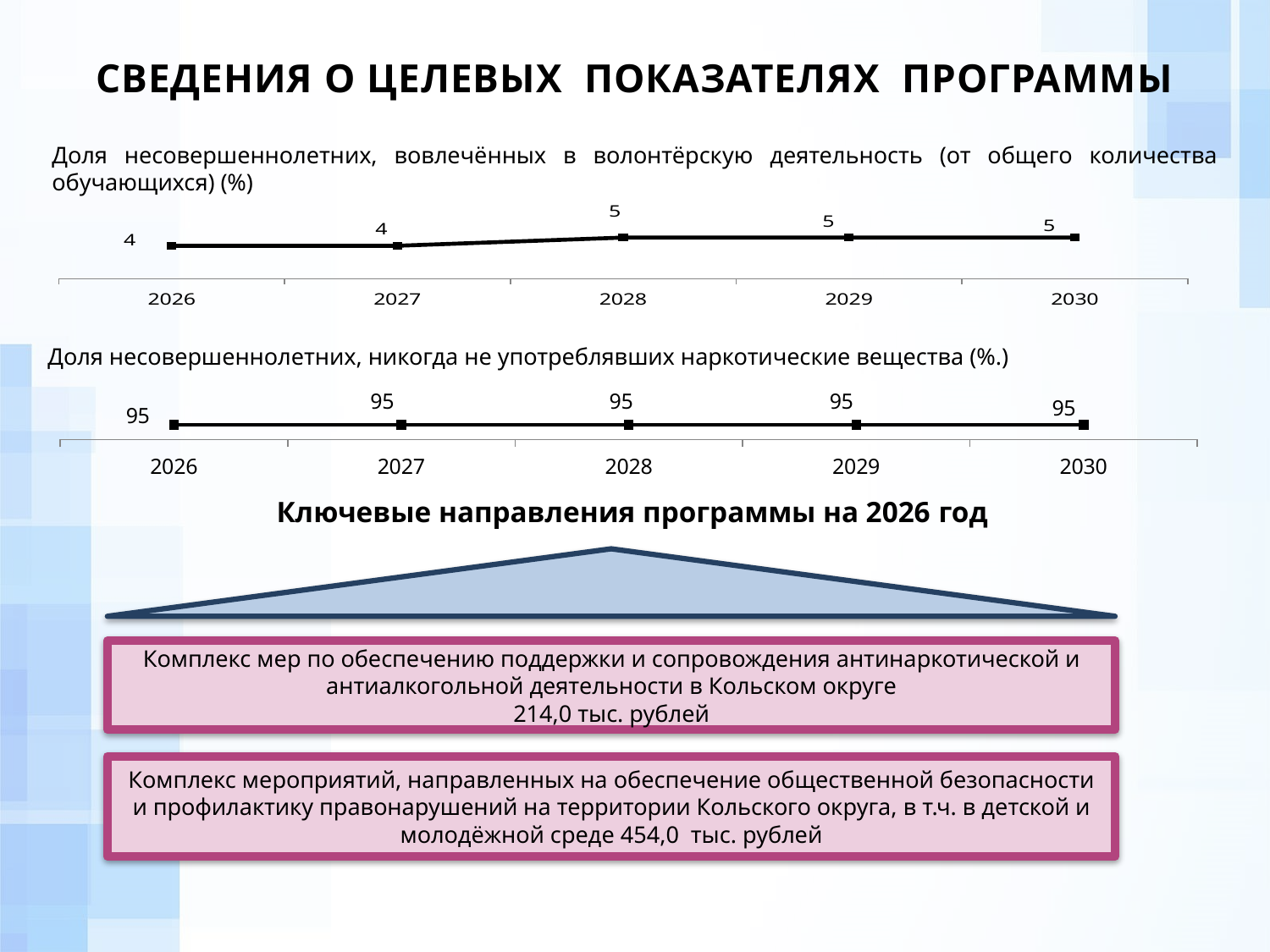
In the top chart (share of minors involved in volunteer activity), do the values rise or fall from 2026 to 2030? rise In the top chart (share of minors involved in volunteer activity), what is the value for 2028? 5 In the bottom chart (share of minors who never used narcotic substances), what is the value for 2027? 95 What kind of chart is the top chart (share of minors involved in volunteer activity)? line chart In the bottom chart (share of minors who never used narcotic substances), do the values rise, fall or stay the same from 2026 to 2030? stay the same In the top chart (share of minors involved in volunteer activity), which is larger, the value for 2027 or the value for 2029? 2029 In the top chart (share of minors involved in volunteer activity), what is the difference between the values for 2030 and 2026? 1 In the bottom chart (share of minors who never used narcotic substances), what is the value for 2030? 95 How many years are plotted in the bottom chart (share of minors who never used narcotic substances)? 5 In the top chart (share of minors involved in volunteer activity), what is the value for 2030? 5 How many years are plotted in the top chart (share of minors involved in volunteer activity)? 5 In the top chart (share of minors involved in volunteer activity), what is the value for 2026? 4